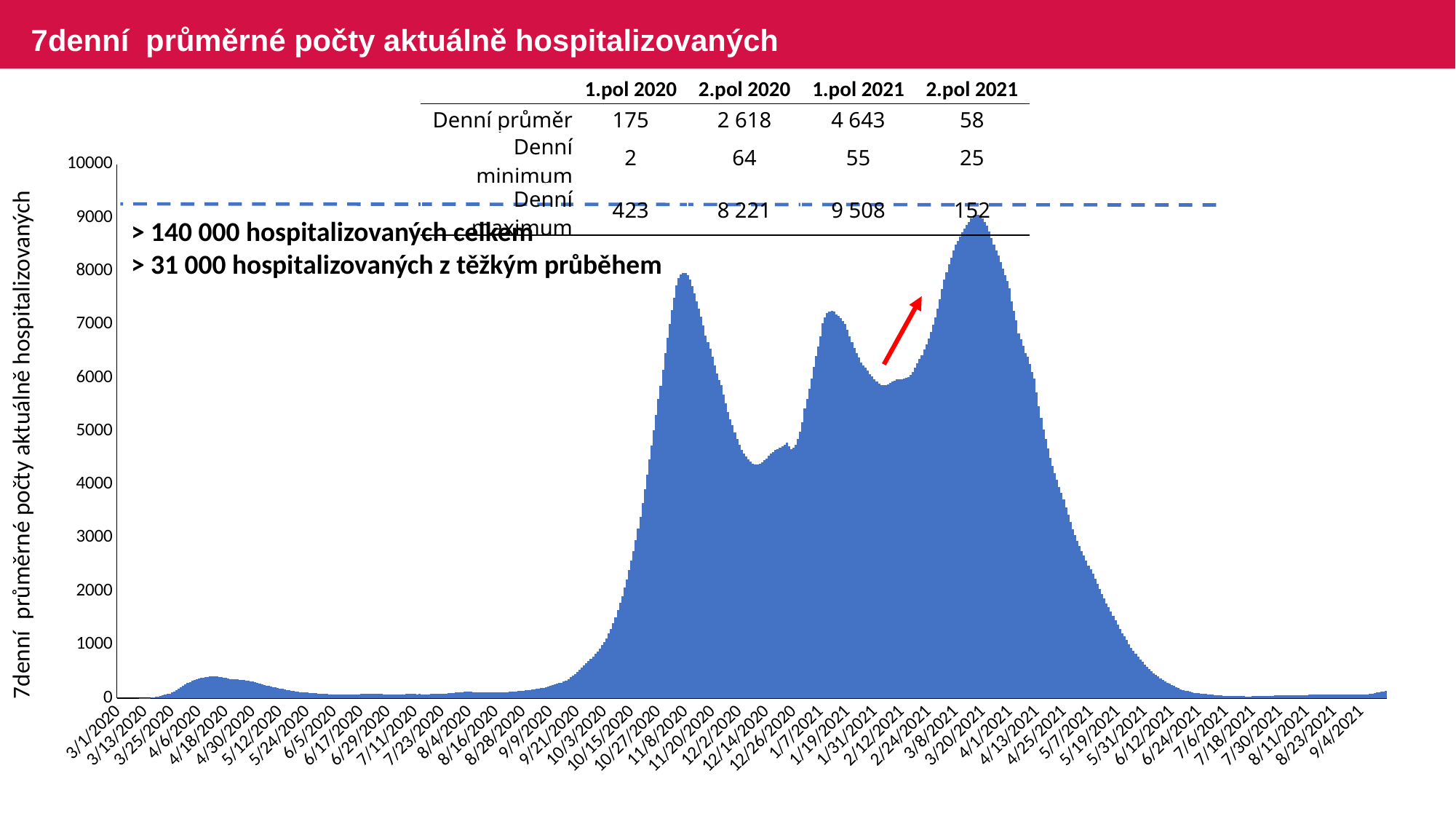
Is the value for 12/14/2020 greater or less than 4000? greater Is the value for 1/7/2021 greater or less than 6000? greater What is the title of the chart? 7denní průměrné počty aktuálně hospitalizovaných Do the values rise or fall between 3/20/2021 and 5/19/2021? fall What type of chart is shown on the slide? bar chart Is the value for 6/24/2021 greater or less than 1000? less Do the values rise or fall between 9/21/2020 and 11/20/2020? rise Around which date does the chart reach its highest value? 3/20/2021 What is the highest tick value shown on the y axis? 10000